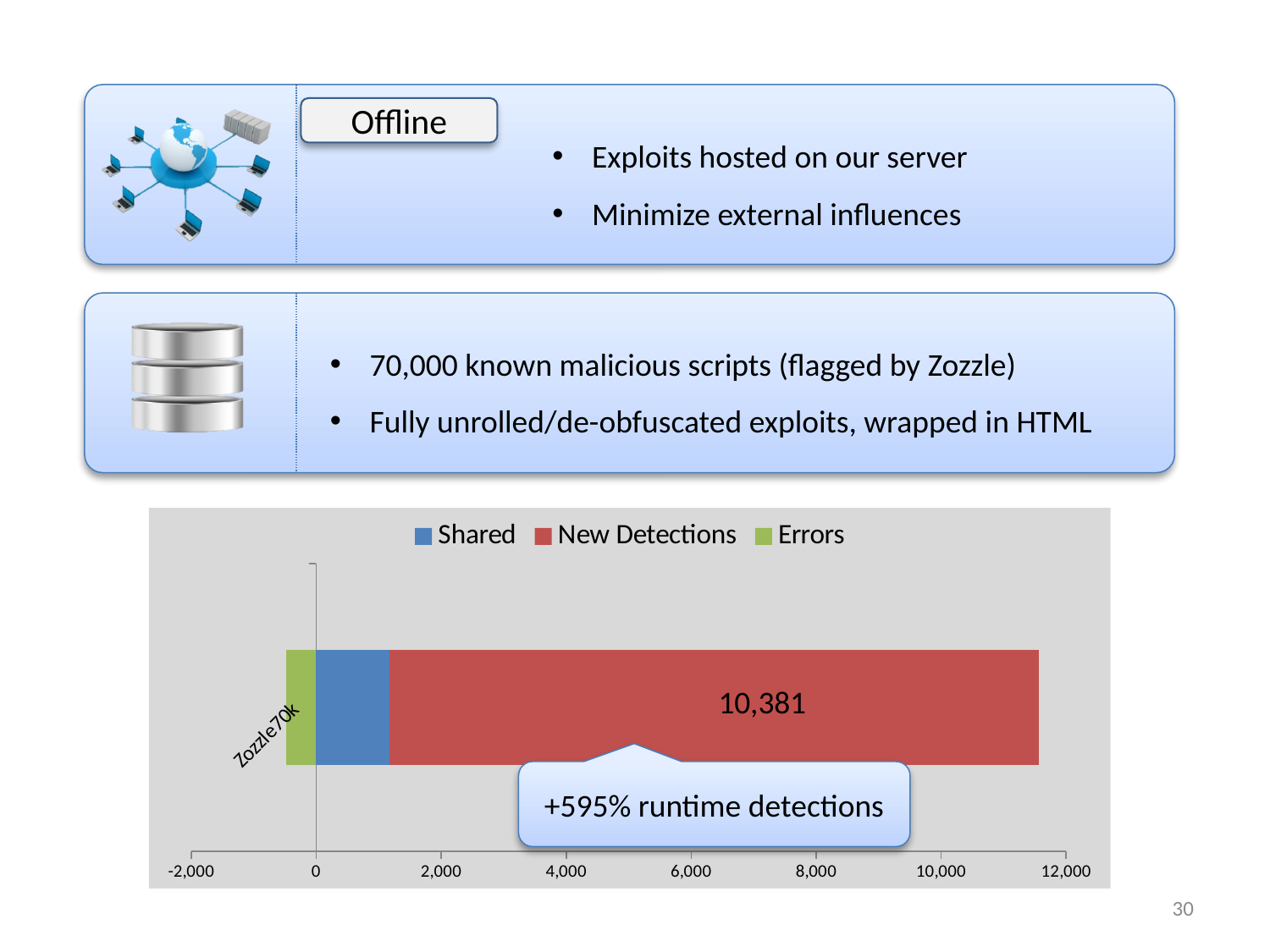
What is the label of the category plotted on the chart? Zozzle70k How many series does the chart legend list? 3 What colour represents the New Detections series in the chart? red What is the value of the New Detections segment for Zozzle70k? 10,381 Which series has the largest value for Zozzle70k? New Detections Is the Shared value for Zozzle70k greater or less than 2,000? less Which is larger for Zozzle70k, the Shared value or the New Detections value? New Detections What kind of chart is shown on the slide? bar chart How many categories are plotted on the chart? 1 Is the New Detections value for Zozzle70k greater or less than 8,000? greater Is the Errors value for Zozzle70k greater or less than 0? less